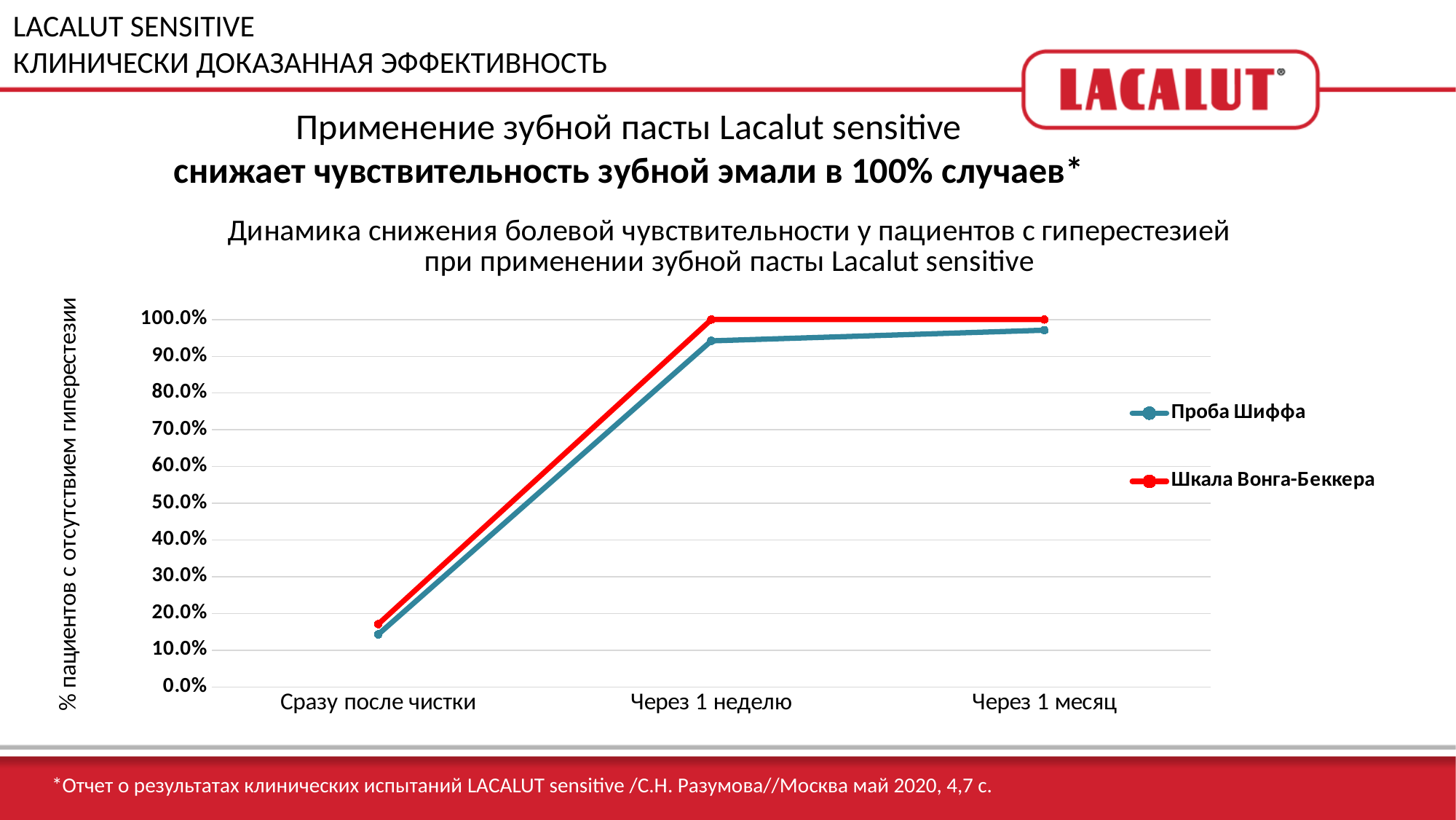
What is the value of Шкала Вонга-Беккера at Через 1 неделю? 100.0% Is the value of Шкала Вонга-Беккера at Сразу после чистки greater or less than 20.0%? less Is the value of Проба Шиффа at Сразу после чистки greater or less than 20.0%? less How many points along the x axis does each series have? 3 Is the value of Проба Шиффа at Через 1 неделю greater or less than 90.0%? greater What is the label of the x-axis category between Сразу после чистки and Через 1 месяц? Через 1 неделю What is the value of Шкала Вонга-Беккера at Через 1 месяц? 100.0% How many series does the legend list? 2 Do the values of Проба Шиффа rise or fall from Сразу после чистки to Через 1 месяц? rise Which series is drawn in red? Шкала Вонга-Беккера What kind of chart is shown on the slide? line chart Which series has the higher value at Через 1 неделю, Проба Шиффа or Шкала Вонга-Беккера? Шкала Вонга-Беккера